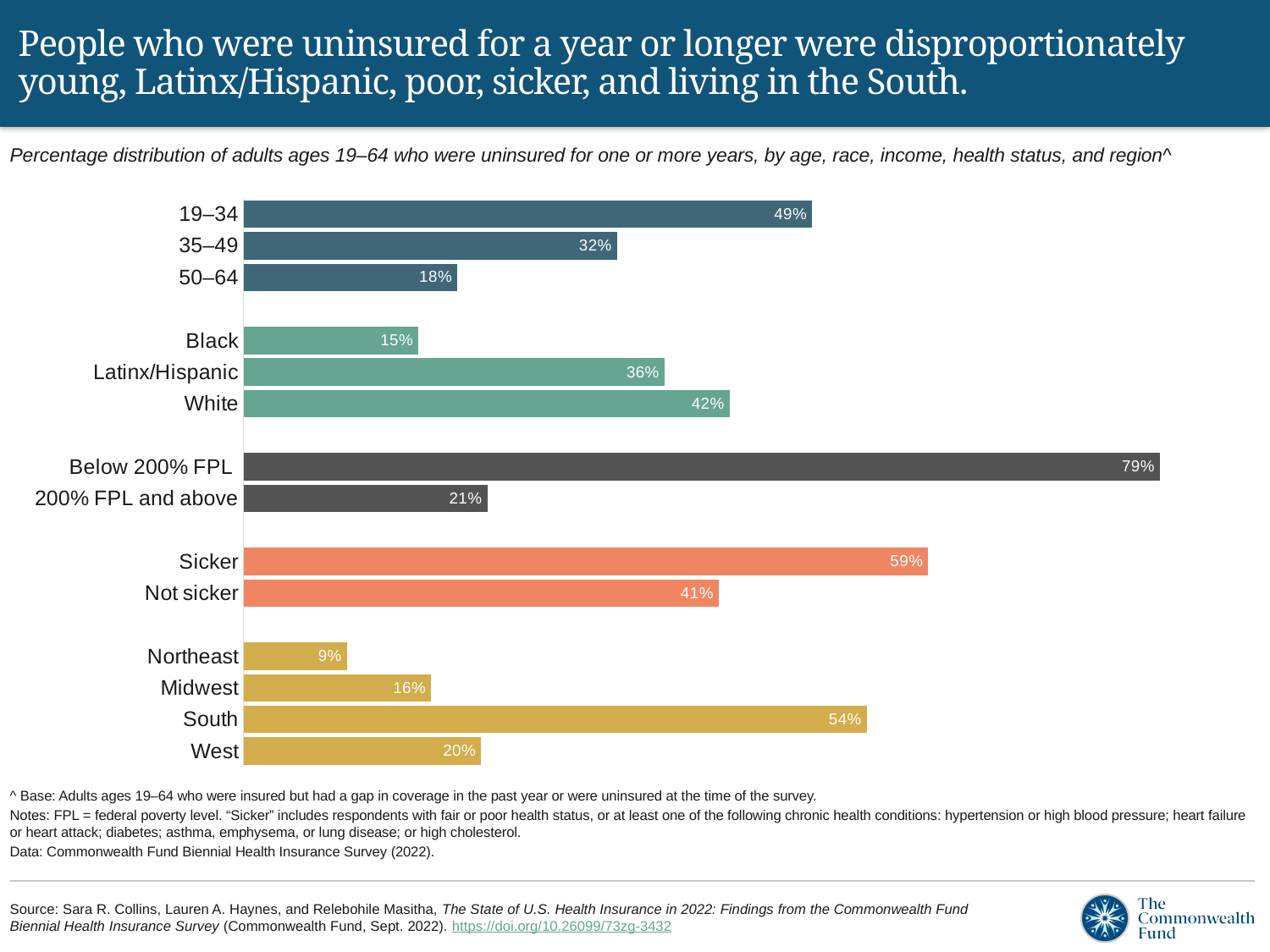
What is the difference between the Sicker and Not sicker values? 18 percentage points What kind of chart is shown on the slide? Bar chart What percentage is shown for Below 200% FPL? 79% What is the value for the South region? 54% Which region has the lowest value? Northeast Which category has the highest value on the chart? Below 200% FPL Which is larger, the value for White or the value for Black? White What is the difference between the values for ages 19–34 and ages 50–64? 31 percentage points How many bars are plotted on the chart? 15 What is the value shown for Latinx/Hispanic? 36% What percentage of adults uninsured for one or more years were ages 19–34? 49% What is the total of the Midwest and West values? 36%